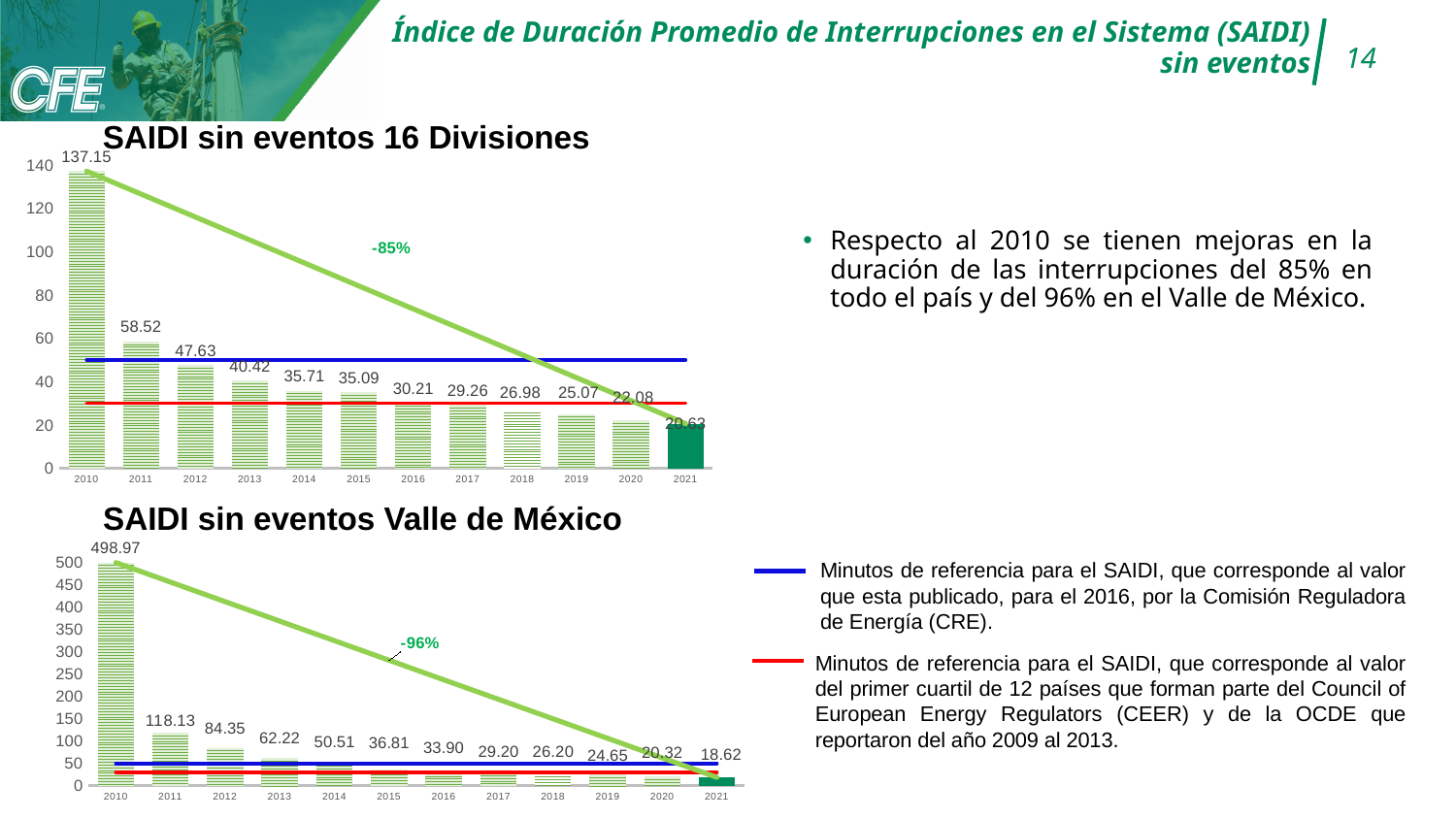
What kind of chart is 'SAIDI sin eventos Valle de México'? Bar chart In the 'SAIDI sin eventos 16 Divisiones' chart, what is the value for 2010? 137.15 In the 'SAIDI sin eventos Valle de México' chart, which is larger, the value for 2012 or the value for 2013? 2012 In the 'SAIDI sin eventos 16 Divisiones' chart, what is the value for 2016? 30.21 In the 'SAIDI sin eventos 16 Divisiones' chart, do the values rise or fall from 2010 to 2021? Fall In the 'SAIDI sin eventos Valle de México' chart, which year has the lowest value? 2021 How many years are shown on the x axis of the 'SAIDI sin eventos 16 Divisiones' chart? 12 In the 'SAIDI sin eventos 16 Divisiones' chart, what is the difference between the 2011 value and the 2012 value? 10.89 In the 'SAIDI sin eventos Valle de México' chart, what is the value for 2011? 118.13 In the 'SAIDI sin eventos 16 Divisiones' chart, which year has the highest value? 2010 In the 'SAIDI sin eventos Valle de México' chart, is the value for 2010 greater or less than 450? greater In the 'SAIDI sin eventos Valle de México' chart, what is the value for 2021? 18.62